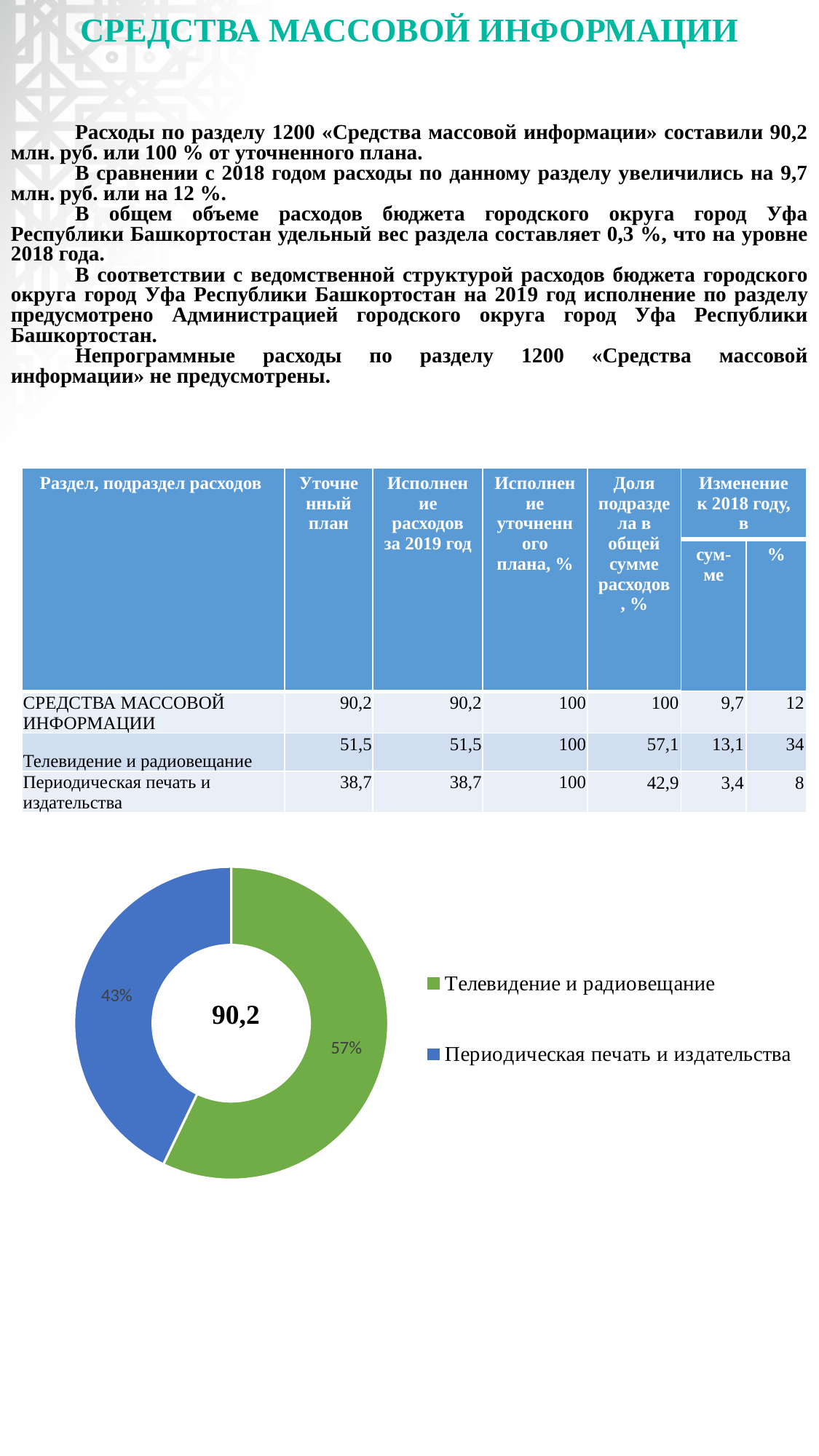
Which slice of the doughnut chart is the smallest? Периодическая печать и издательства How many entries does the legend of the doughnut chart list? 2 Which is larger in the doughnut chart: "Телевидение и радиовещание" or "Периодическая печать и издательства"? Телевидение и радиовещание What share of the doughnut chart does "Телевидение и радиовещание" take? 57% What is the difference in percentage points between the "Телевидение и радиовещание" slice and the "Периодическая печать и издательства" slice? 14 percentage points What kind of chart is shown on the slide? Doughnut (pie) chart What share of the doughnut chart does "Периодическая печать и издательства" take? 43% How many slices does the doughnut chart have? 2 Which slice of the doughnut chart is the largest? Телевидение и радиовещание What colour is the "Периодическая печать и издательства" slice in the doughnut chart? Blue What number is printed in the centre of the doughnut chart? 90,2